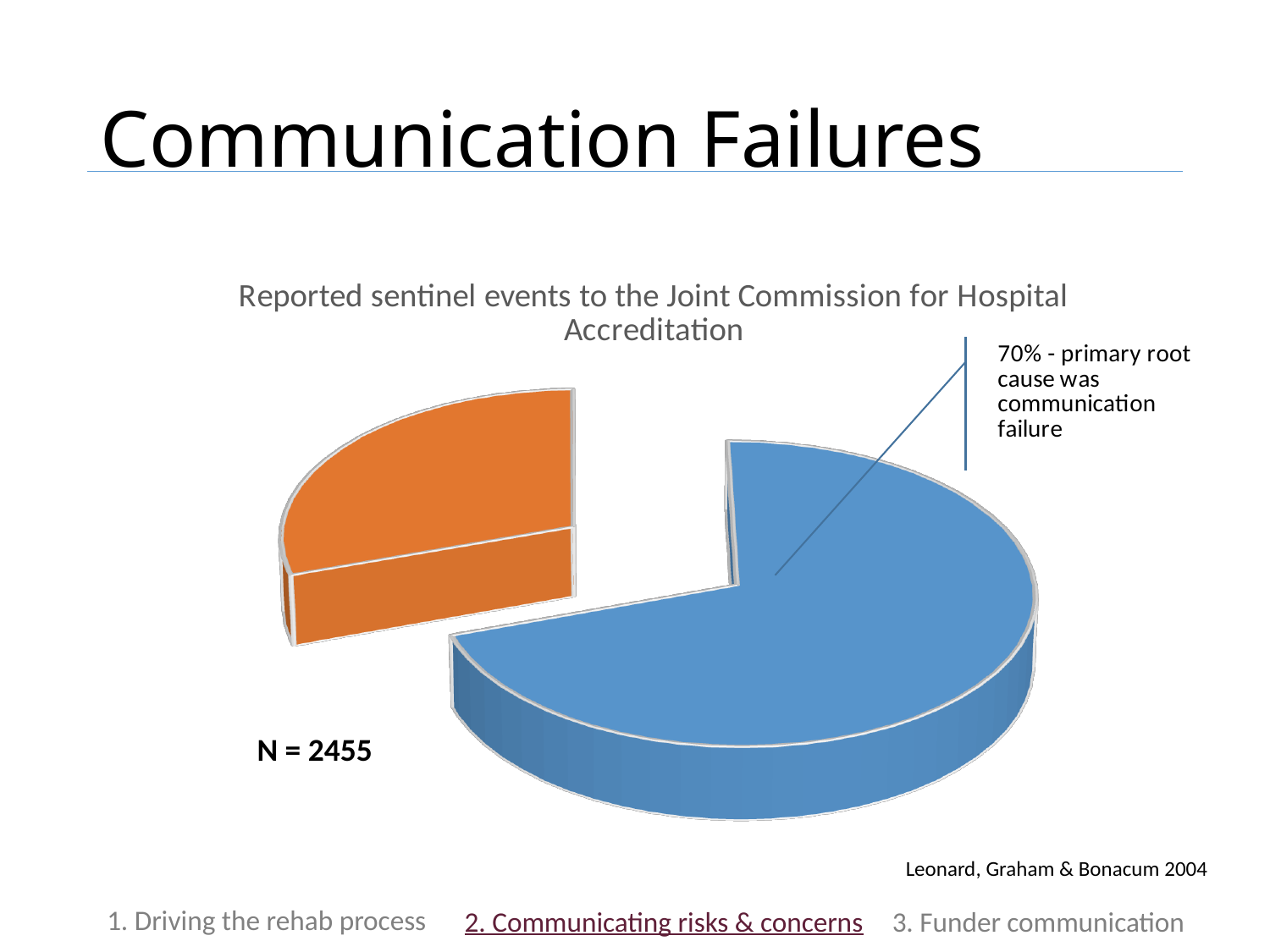
Which slice represents the smallest share of the pie chart? the orange slice What kind of chart is shown on the slide? pie chart What is the title of the pie chart? Reported sentinel events to the Joint Commission for Hospital Accreditation Which slice represents the largest share of the pie chart? the blue slice (communication failure) How many slices does the pie chart have? 2 Which slice of the pie chart is larger, the blue slice or the orange slice? the blue slice What share of reported sentinel events had communication failure as the primary root cause? 70% What is the sample size (N) shown next to the pie chart? N = 2455